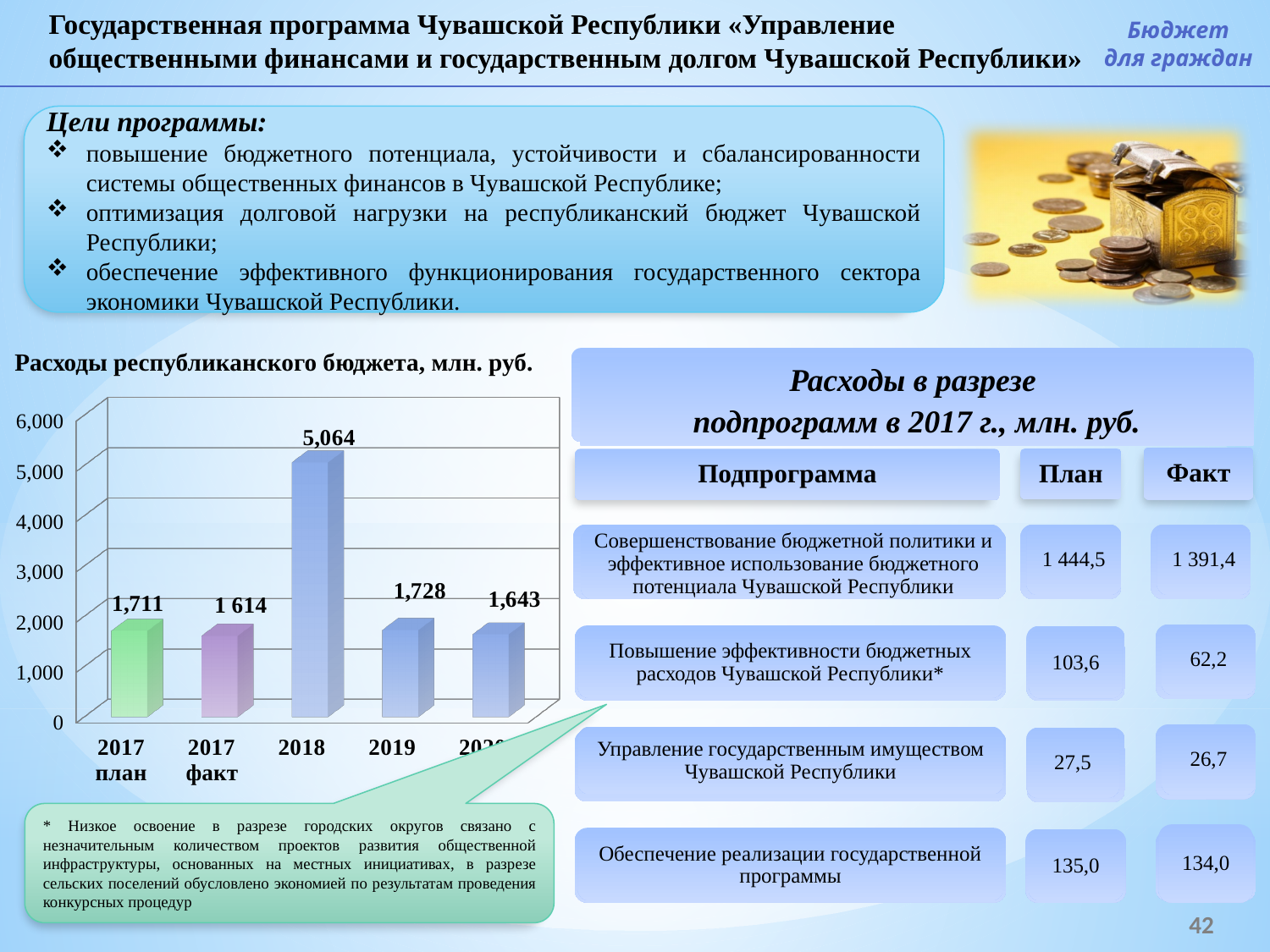
What is the difference between the values for '2017 план' and '2017 факт' in the chart? 97 Which category has the lowest value in the chart? 2017 факт What is the value for '2017 факт' in the chart? 1 614 What is the difference between the values for 2018 and 2019 in the chart? 3,336 Which is larger in the chart: the value for '2017 план' or the value for 2019? 2019 What is the value for 2018 in the chart 'Расходы республиканского бюджета, млн. руб.'? 5,064 Which category has the highest value in the chart? 2018 Is the value for 2018 in the chart greater or less than 4,000? greater What is the value for '2017 план' in the chart? 1,711 What type of chart is shown on the slide? bar chart How many bars are shown in the chart? 5 What is the value for 2019 in the chart? 1,728